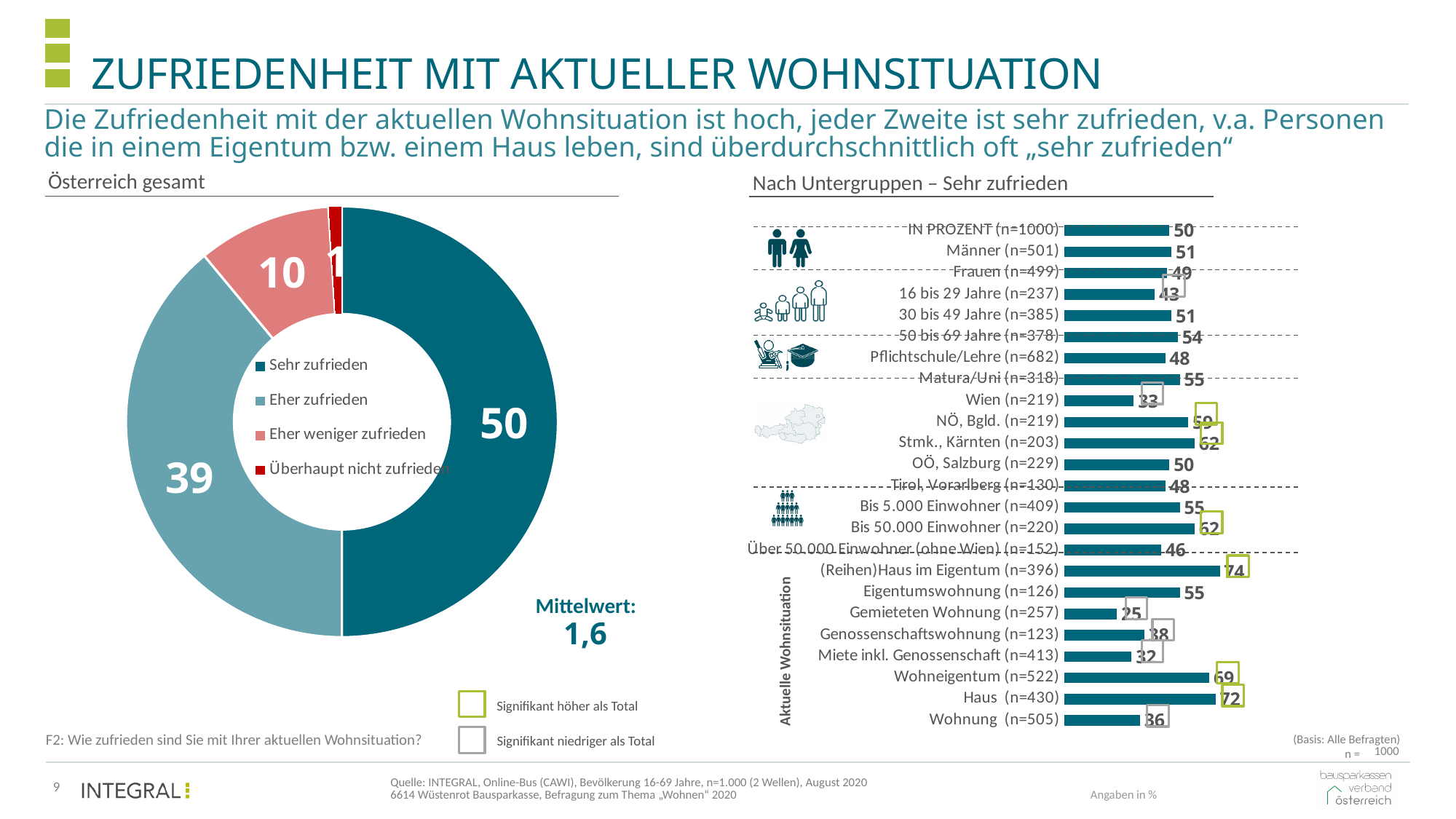
In the 'Nach Untergruppen – Sehr zufrieden' chart, what is the value for '(Reihen)Haus im Eigentum (n=396)'? 74 In the 'Nach Untergruppen – Sehr zufrieden' chart, what is the difference between 'Matura/Uni (n=318)' and 'Pflichtschule/Lehre (n=682)'? 7 In the 'Nach Untergruppen – Sehr zufrieden' chart, which subgroup has the highest value? (Reihen)Haus im Eigentum (n=396) In the 'Nach Untergruppen – Sehr zufrieden' chart, what is the value for 'Männer (n=501)'? 51 What kind of chart is the 'Österreich gesamt' chart? Donut (pie) chart In the 'Österreich gesamt' chart, what percentage is 'Sehr zufrieden'? 50 In the 'Österreich gesamt' chart, what percentage is 'Eher zufrieden'? 39 What is the Mittelwert shown next to the 'Österreich gesamt' chart? 1,6 What kind of chart is the 'Nach Untergruppen – Sehr zufrieden' chart? Bar chart In the 'Österreich gesamt' chart, which category has the smallest share? Überhaupt nicht zufrieden In the 'Österreich gesamt' chart, what is the difference between 'Eher zufrieden' and 'Eher weniger zufrieden'? 29 In the 'Nach Untergruppen – Sehr zufrieden' chart, which is larger: '50 bis 69 Jahre (n=378)' or '16 bis 29 Jahre (n=237)'? 50 bis 69 Jahre (n=378)